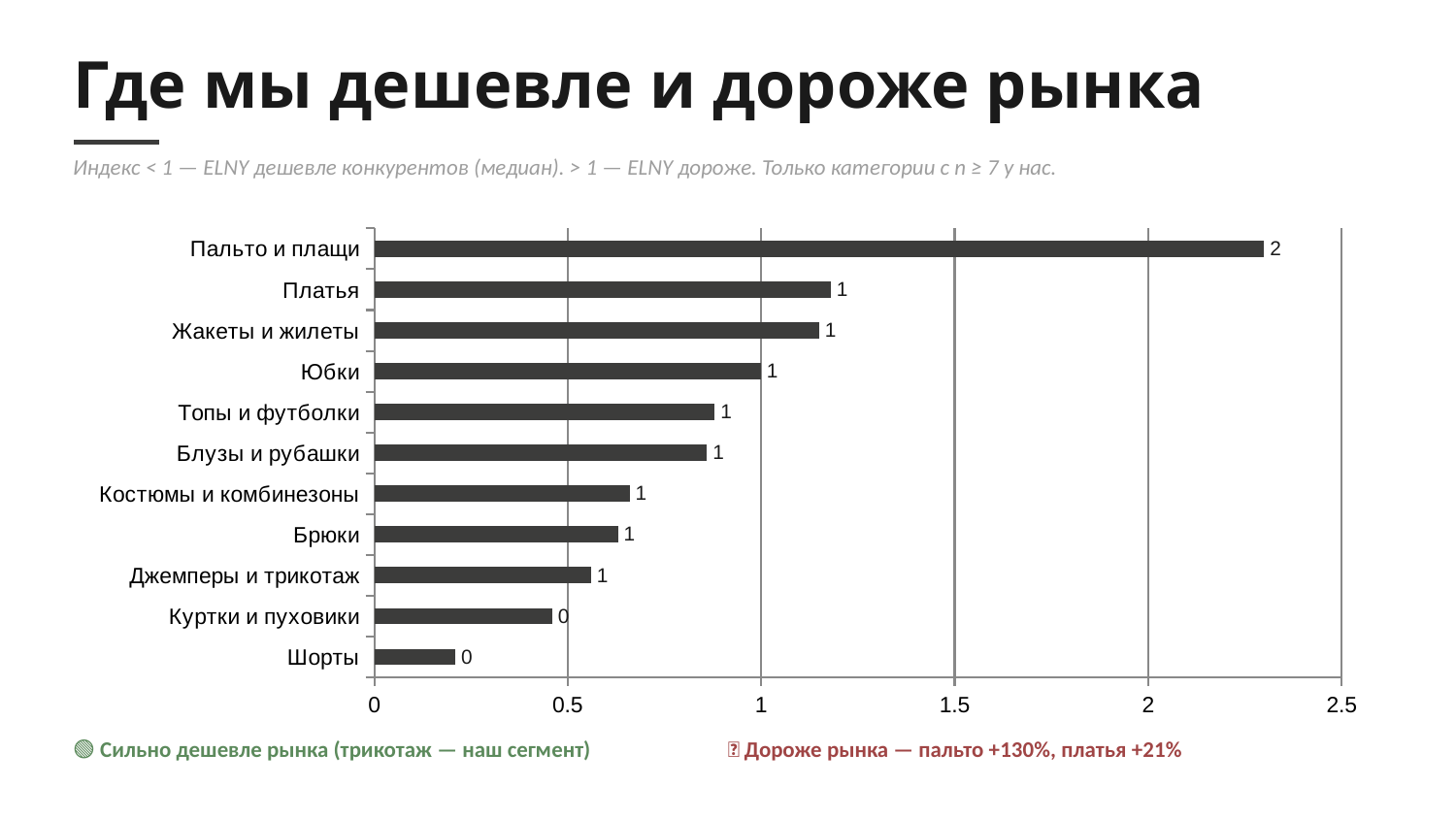
Is the value for Пальто и плащи greater or less than 2? greater Which category has the lowest value in the chart? Шорты What kind of chart is shown on the slide? bar chart Is the value for Шорты greater or less than 0.5? less What data label is shown for Шорты? 0 What is the title of the slide containing the chart? Где мы дешевле и дороже рынка Which is larger, the value for Пальто и плащи or the value for Платья? Пальто и плащи What data label is shown for Пальто и плащи? 2 Is the value for Платья greater or less than 1? greater Which category has the highest value in the chart? Пальто и плащи How many categories are plotted in the chart? 11